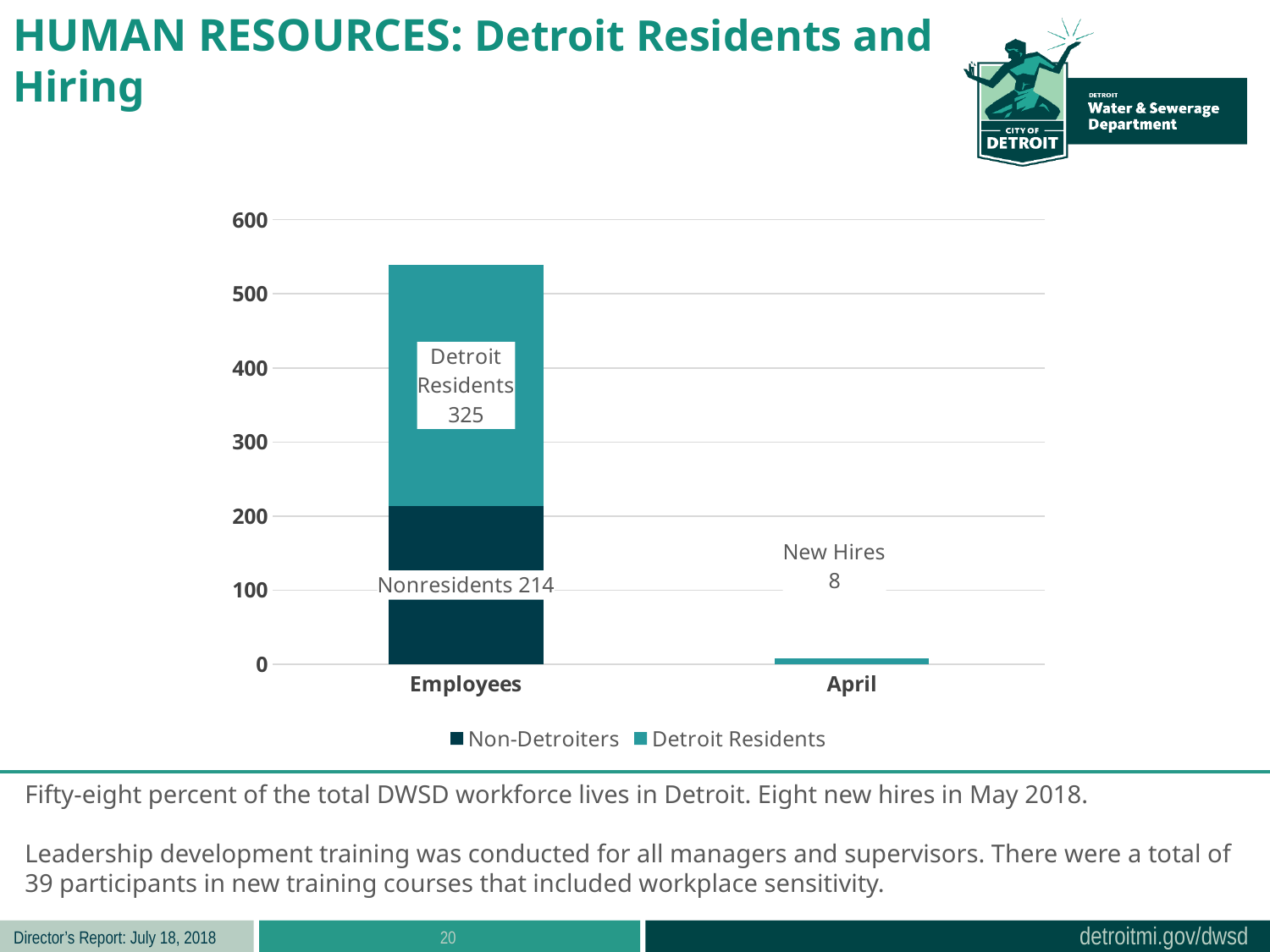
How many categories are shown on the x axis? 2 What are the two series named in the legend? Non-Detroiters and Detroit Residents What kind of chart is shown on the slide? stacked bar chart Which category has the lower total bar height, Employees or April? April What is the difference between Detroit Residents (325) and Nonresidents (214) in the Employees bar? 111 What is the total of the stacked Employees bar? 539 What is the value labelled for Detroit Residents in the Employees bar? 325 What is the value labelled for Nonresidents in the Employees bar? 214 Is the total height of the Employees bar greater or less than 500? greater How many series does the legend list? 2 Which is larger in the Employees bar, Detroit Residents or Nonresidents? Detroit Residents What is the value labelled for New Hires in the April bar? 8